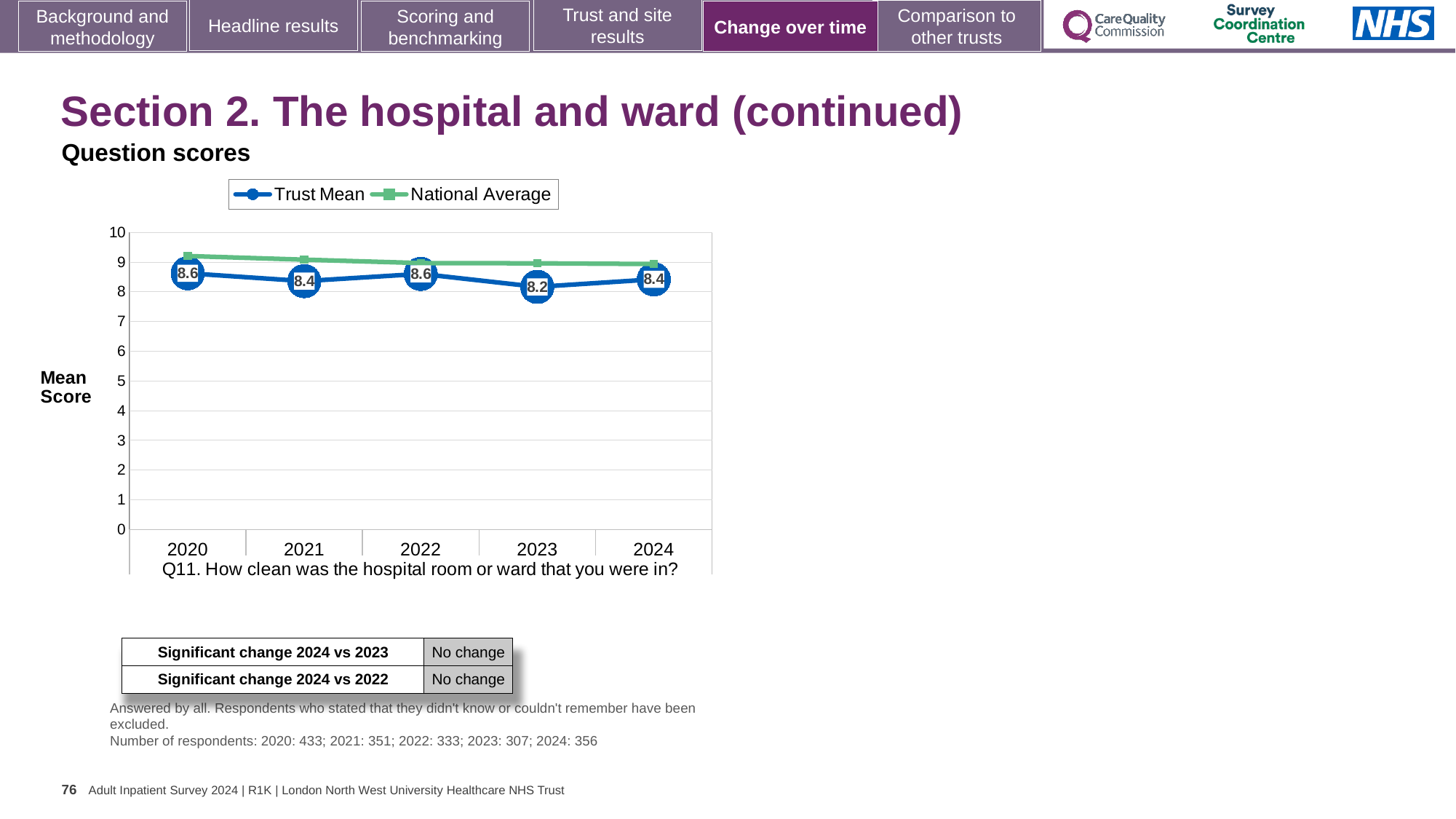
Is the National Average value for 2020 greater or less than 9? greater What kind of chart is shown on the slide? line chart How many years are shown on the x axis of the chart? 5 In 2020, which series has the higher value, Trust Mean or National Average? National Average Which year has the higher Trust Mean score, 2021 or 2023? 2021 What is the Trust Mean score for 2020? 8.6 How many series does the chart legend list? 2 What is the Trust Mean score for 2023? 8.2 What is the Trust Mean score for 2024? 8.4 In which year is the Trust Mean score lowest? 2023 Does the Trust Mean score rise or fall from 2022 to 2023? fall What is the difference between the Trust Mean scores for 2022 and 2023? 0.4